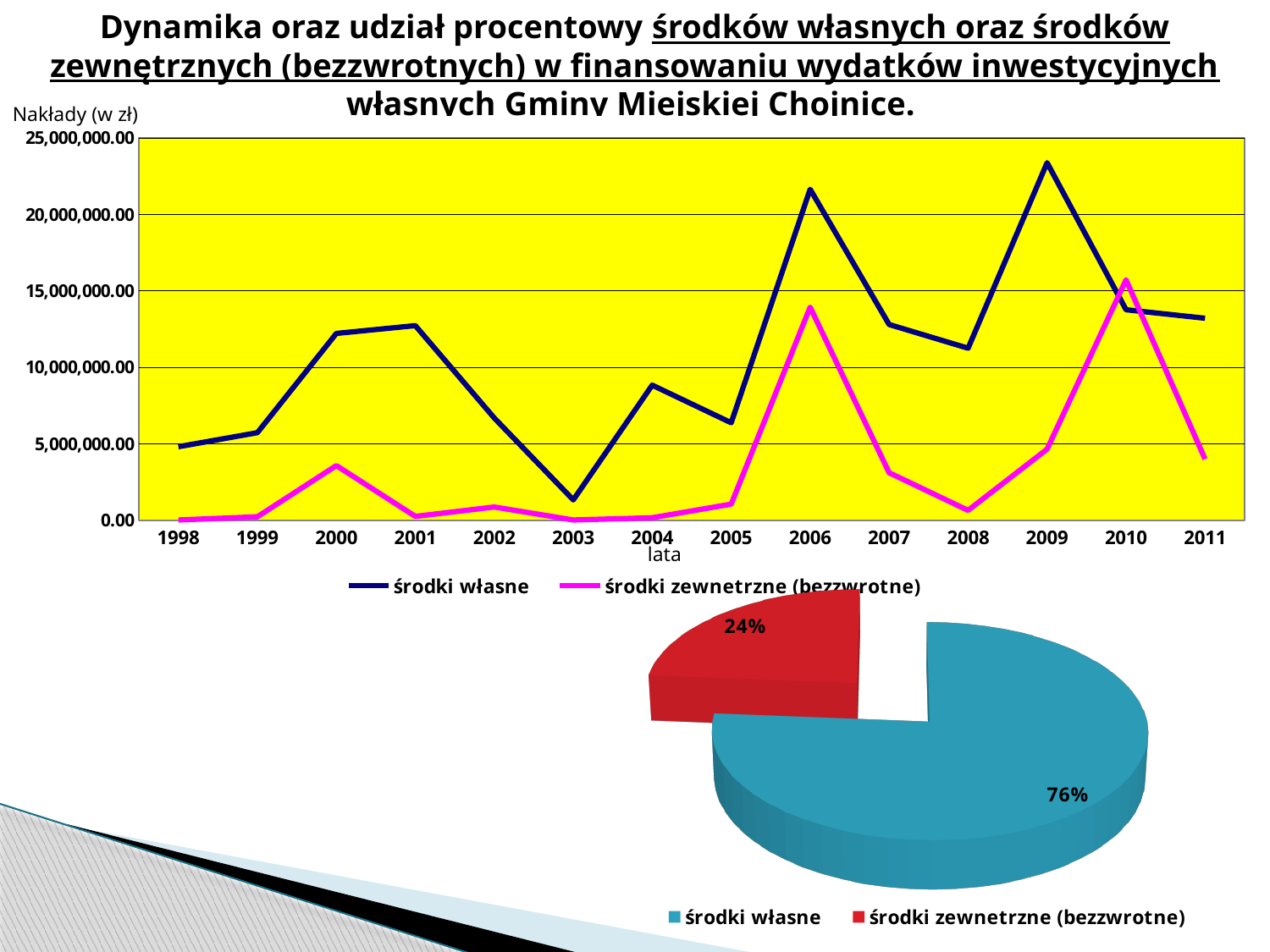
What kind of chart is the top chart on the slide? line chart On the bottom pie chart, what is the difference in percentage points between the środki własne slice and the środki zewnetrzne (bezzwrotne) slice? 52 percentage points On the top line chart, how many years are shown on the x axis? 14 On the top line chart, is the value for środki zewnetrzne (bezzwrotne) in 2006 greater or less than 15,000,000.00? less On the top line chart, is the value for środki własne in 2006 greater or less than 20,000,000.00? greater On the top line chart, which series has the larger value in 2010, środki własne or środki zewnetrzne (bezzwrotne)? środki zewnetrzne (bezzwrotne) On the top line chart, in which year does the środki własne series reach its highest value? 2009 On the top line chart, in which year does the środki własne series reach its lowest value? 2003 On the top line chart, is the value for środki własne in 2003 greater or less than 5,000,000.00? less On the top line chart, in which year does the środki zewnetrzne (bezzwrotne) series reach its highest value? 2010 On the top line chart, how many series does the legend list? 2 On the bottom pie chart, what share does środki własne have? 76%